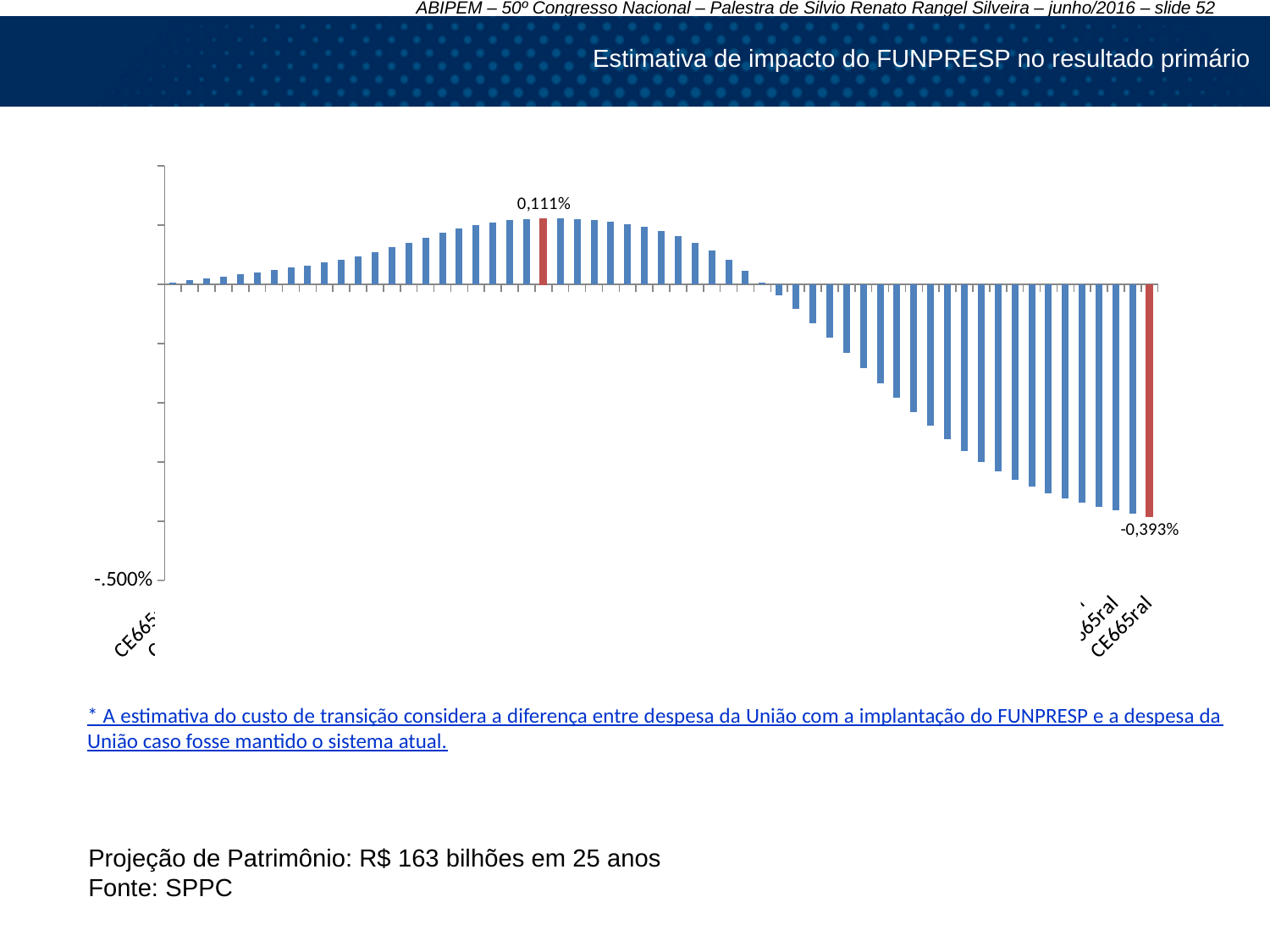
What is the difference between the two labeled values, 0,111% and -0,393%? 0,504% What is the highest value labeled on the chart? 0,111% How many data labels are printed on the chart? 2 What is the title shown above the chart on the slide? Estimativa de impacto do FUNPRESP no resultado primário Is the value of the last bar on the right greater or less than -.500%? greater After reaching the peak of 0,111%, do the values rise or fall moving to the right along the x axis? fall What is the lowest value labeled on the chart? -0,393% Which of the two labeled values is larger, the one on the first red bar or the one on the last red bar? 0,111% (the first red bar) What is the only value label printed on the vertical axis? -.500% Are the bars on the right half of the chart positive or negative? negative What kind of chart is shown on the slide? bar chart How many bars are highlighted in red? 2